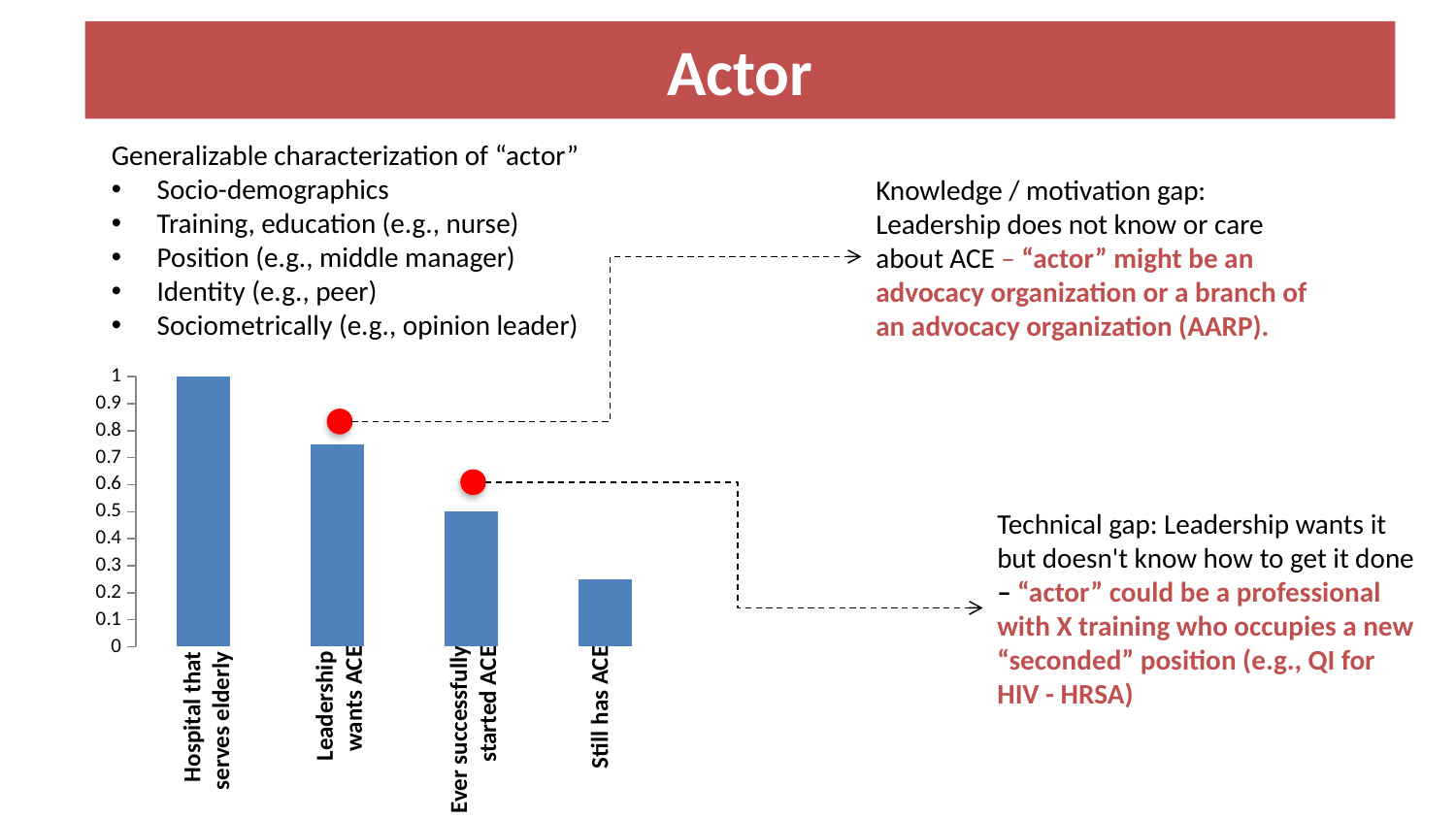
What is the value for "Hospital that serves elderly"? 1 What is the difference between the values for "Hospital that serves elderly" and "Ever successfully started ACE"? 0.5 Which category has the lowest bar in the chart? Still has ACE What is the highest tick value shown on the vertical axis of the chart? 1 Is the value for "Leadership wants ACE" greater or less than 0.7? greater What kind of chart is shown on the slide? bar chart Which category has the highest bar in the chart? Hospital that serves elderly Do the bar values rise or fall from left to right along the x axis? fall What is the value for "Ever successfully started ACE"? 0.5 Is the value for "Still has ACE" greater or less than 0.3? less How many categories are plotted in the bar chart? 4 Which is larger, the value for "Leadership wants ACE" or the value for "Still has ACE"? Leadership wants ACE